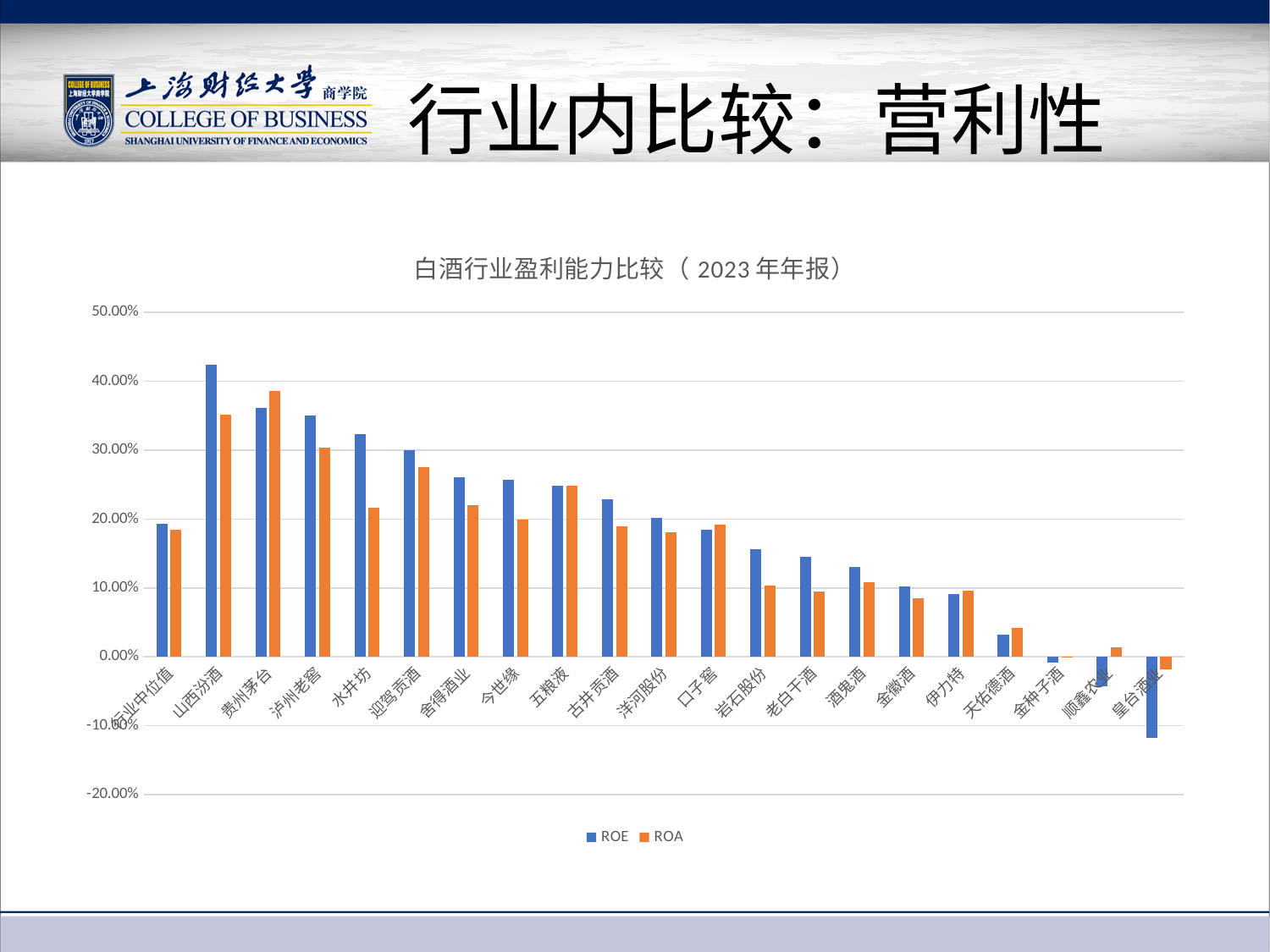
Is the ROE value for 皇台酒业 greater or less than -10.00%? less What is the title of the chart? 白酒行业盈利能力比较（2023年年报） Do the ROE values generally rise or fall moving from left to right along the x axis (after 行业中位值)? Fall Which category has the highest ROE? 山西汾酒 Which category has the lowest ROE? 皇台酒业 For 贵州茅台, which is larger, ROE or ROA? ROA How many companies/categories are shown on the x axis? 21 What kind of chart is shown on the slide? Bar chart How many series does the legend list? 2 Which category has the highest ROA? 贵州茅台 What are the two series named in the legend? ROE and ROA Is the ROE value for 山西汾酒 greater or less than 40.00%? greater